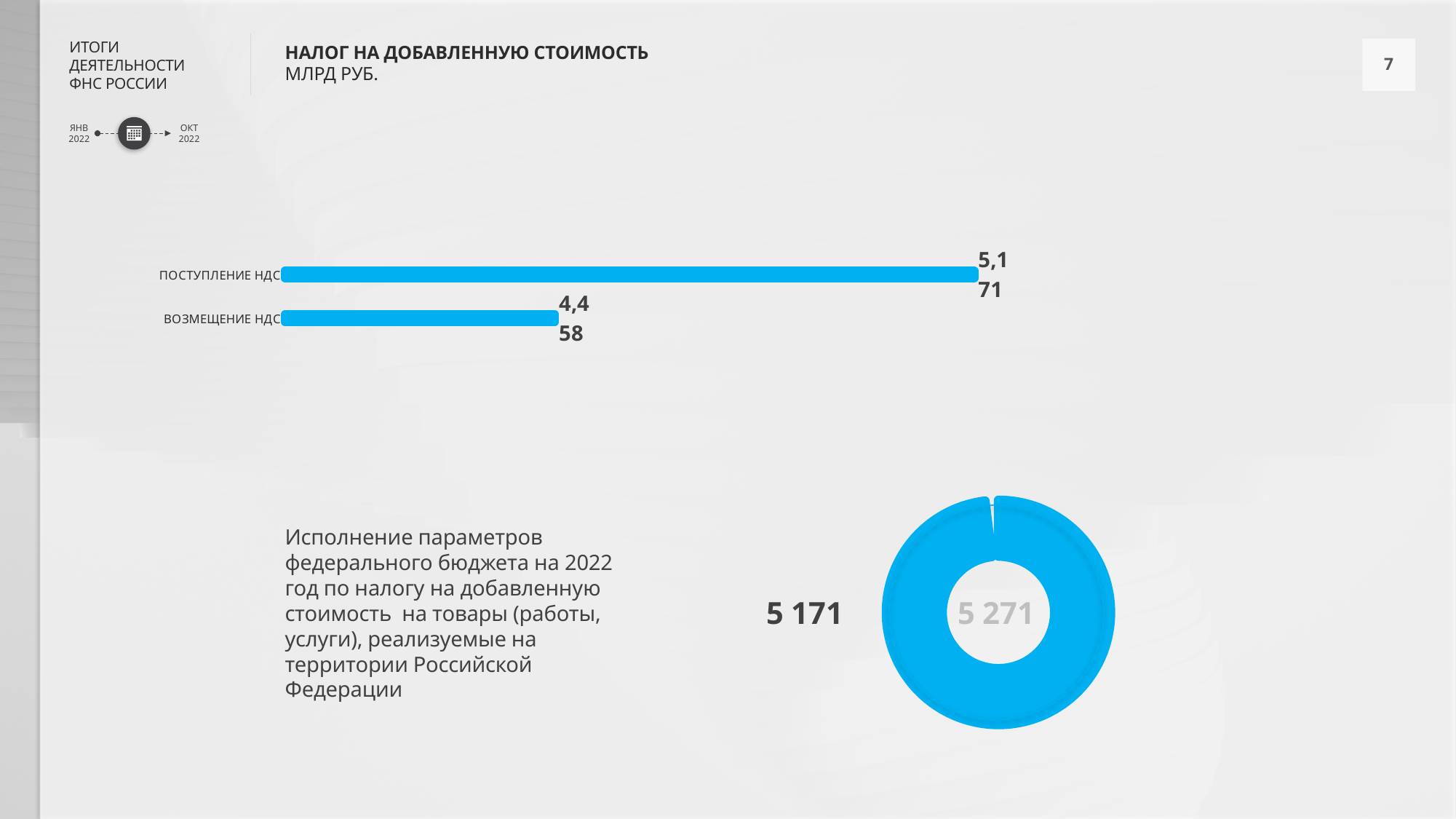
How many categories does the bar chart show? 2 In the bar chart, is the value for ПОСТУПЛЕНИЕ НДС larger or smaller than the value for ВОЗМЕЩЕНИЕ НДС? larger What type of chart is the chart at the bottom right of the slide? donut chart What unit is stated under the title НАЛОГ НА ДОБАВЛЕННУЮ СТОИМОСТЬ? МЛРД РУБ. In the bar chart, what is the value for ВОЗМЕЩЕНИЕ НДС? 4,458 In the donut chart at the bottom right, what number is shown in the centre of the ring? 5 271 In the bar chart, which category has the lower value? ВОЗМЕЩЕНИЕ НДС In the bar chart, which category has the higher value? ПОСТУПЛЕНИЕ НДС What type of chart is the chart at the top of the slide? bar chart In the bar chart, what is the value for ПОСТУПЛЕНИЕ НДС? 5,171 In the bar chart, what is the difference between ПОСТУПЛЕНИЕ НДС and ВОЗМЕЩЕНИЕ НДС? 713 In the donut chart at the bottom right, what value is labelled to the left of the ring? 5 171